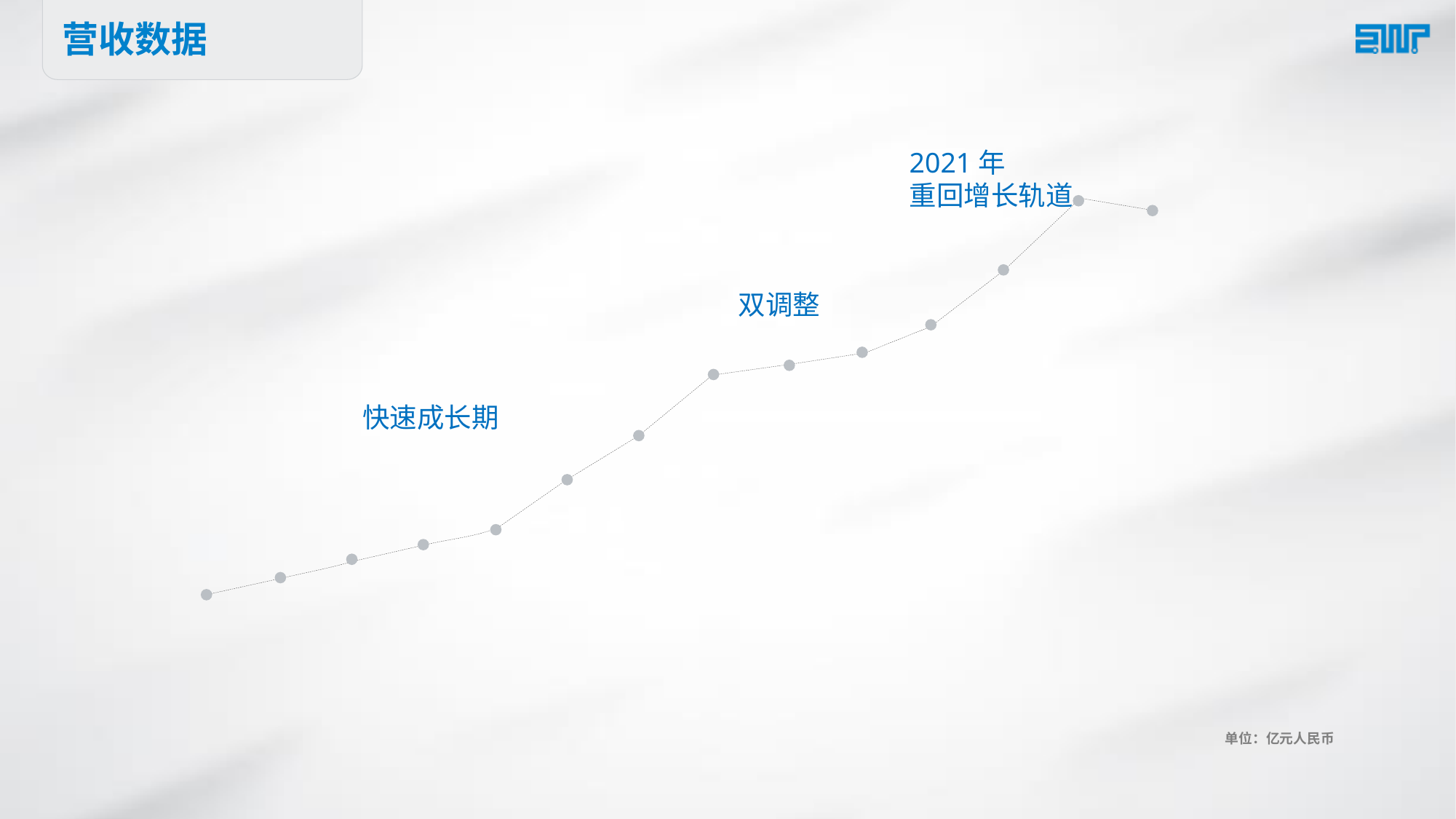
What unit is stated for the chart's values? 亿元人民币 Do the values generally rise or fall from left to right along the line? rise What kind of chart is shown on the slide? line chart What is the title of the slide containing the chart? 营收数据 Is the last point on the line higher or lower than the point immediately before it? lower How many data points are plotted on the line? 14 Is the rightmost point on the line higher or lower than the leftmost point? higher